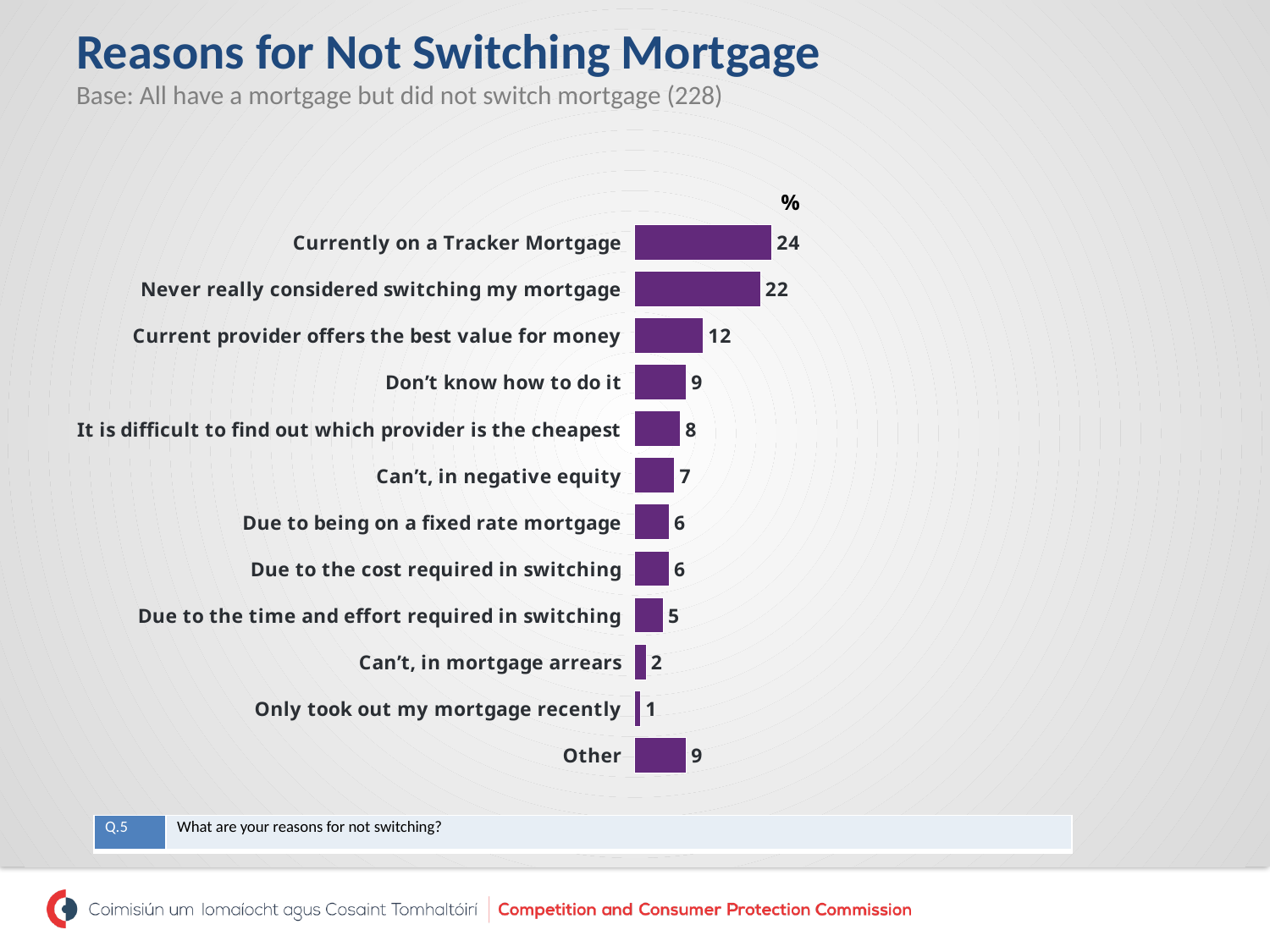
Which reason has the highest value? Currently on a Tracker Mortgage What is the base size stated under the chart title? 228 What is the value for "Can't, in mortgage arrears"? 2 What kind of chart is shown on the slide? Bar chart What is the value for "Don't know how to do it"? 9 What is the difference between "Never really considered switching my mortgage" and "Other"? 13 What is the difference between "Currently on a Tracker Mortgage" and "Current provider offers the best value for money"? 12 Which is larger: "Can't, in negative equity" or "Due to the time and effort required in switching"? Can't, in negative equity What percentage of respondents said they are currently on a tracker mortgage? 24 What is the value for "Never really considered switching my mortgage"? 22 Which reason has the lowest value? Only took out my mortgage recently How many reasons are listed in the chart? 12